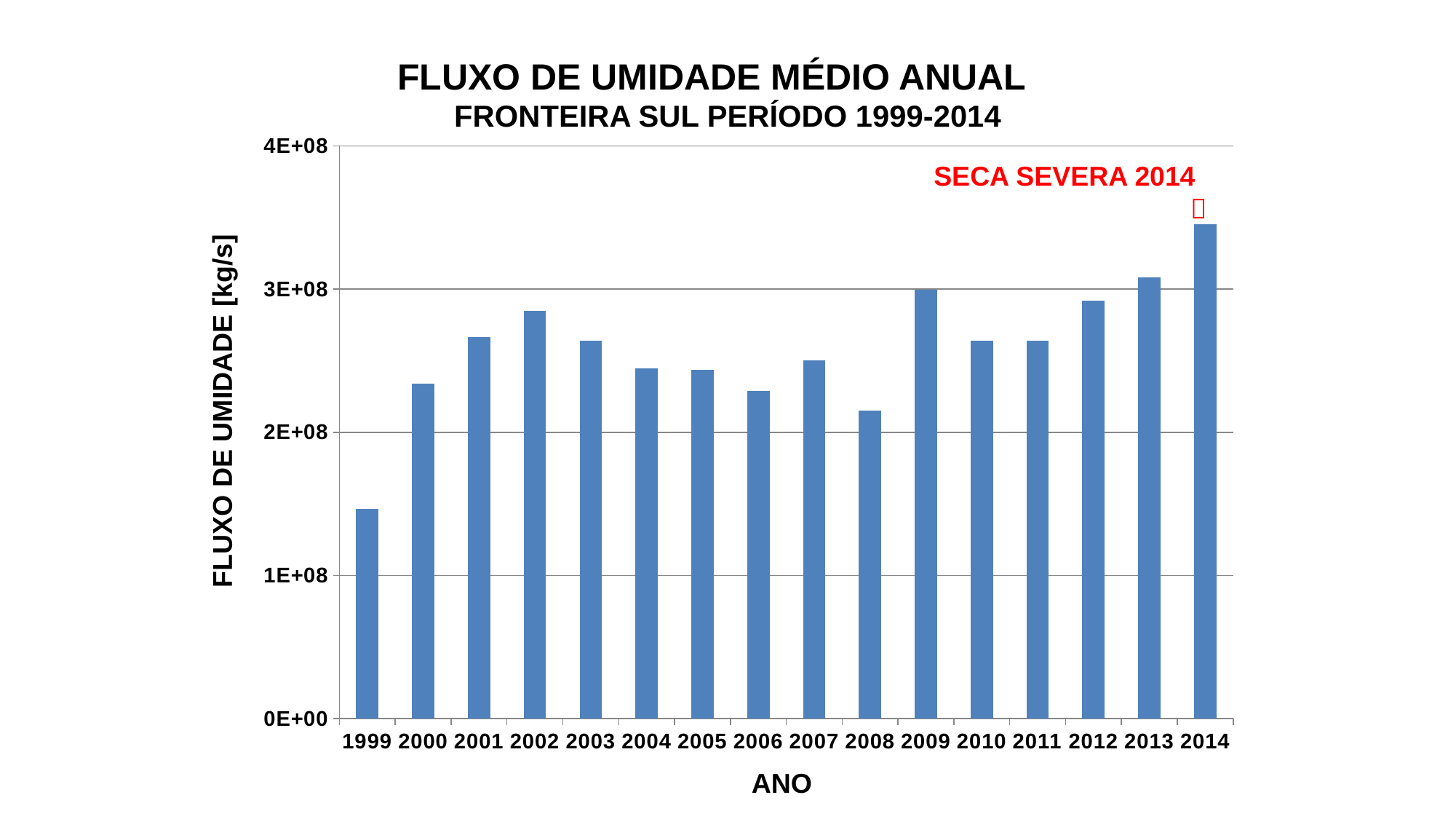
Which year has the highest annual mean moisture flux? 2014 What kind of chart is shown on the slide? bar chart Is the value for 2008 greater or less than 2E+08? greater Is the value for 2002 greater or less than 3E+08? less Is the value for 1999 greater or less than 2E+08? less Which year has the larger value, 2002 or 2003? 2002 Which year has the lowest annual mean moisture flux? 1999 Which year has the larger value, 2008 or 2009? 2009 What is the label of the vertical axis? FLUXO DE UMIDADE [kg/s] How many years (bars) are plotted on the chart? 16 Do the values rise or fall from 2011 to 2014? rise